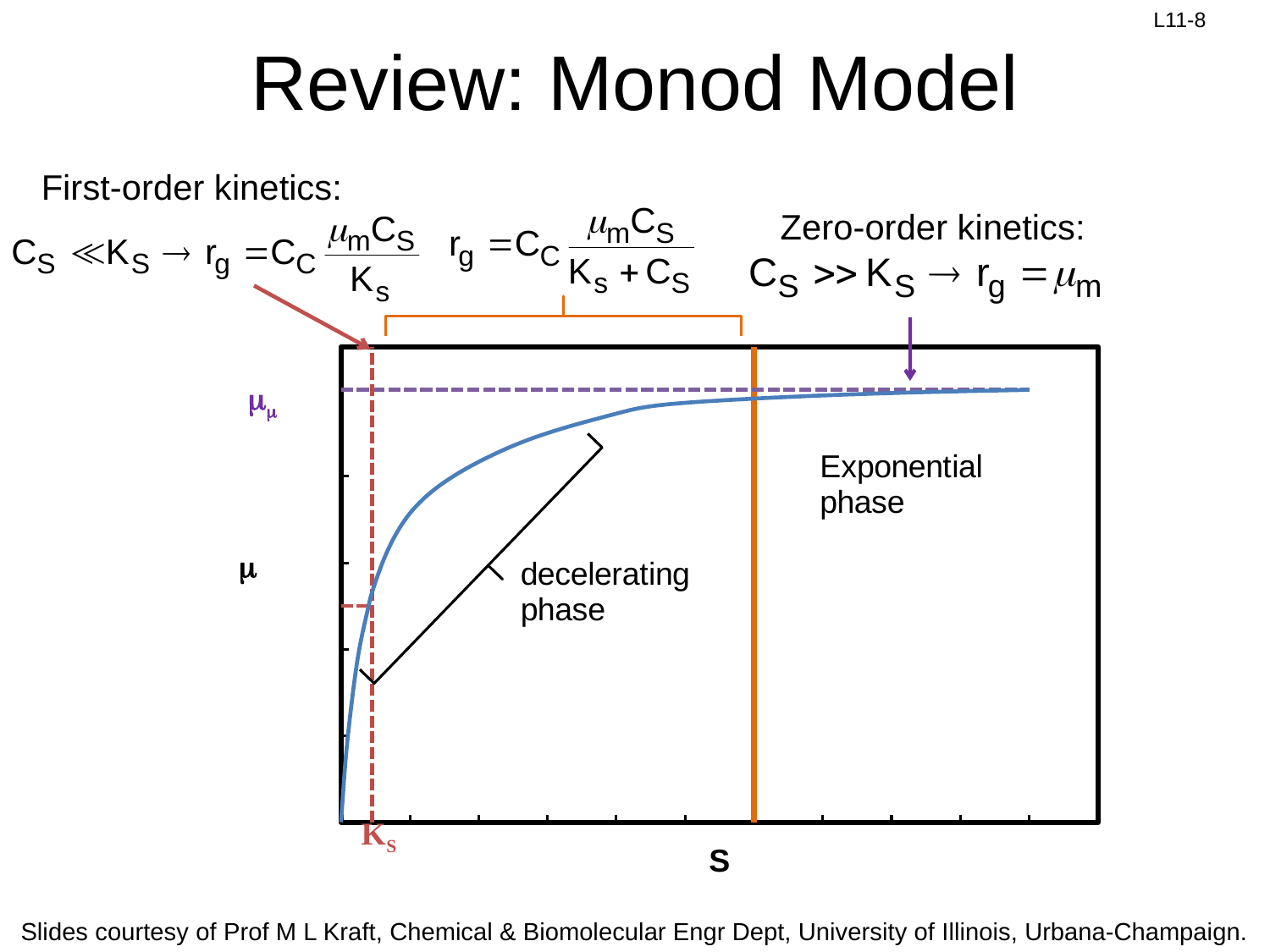
What is the label on the x axis of the chart? S What kind of chart is shown on the slide? line chart Does the plotted curve rise or fall as S increases along the x axis? rise Which phase is labeled to the right of the orange vertical line in the chart? Exponential phase